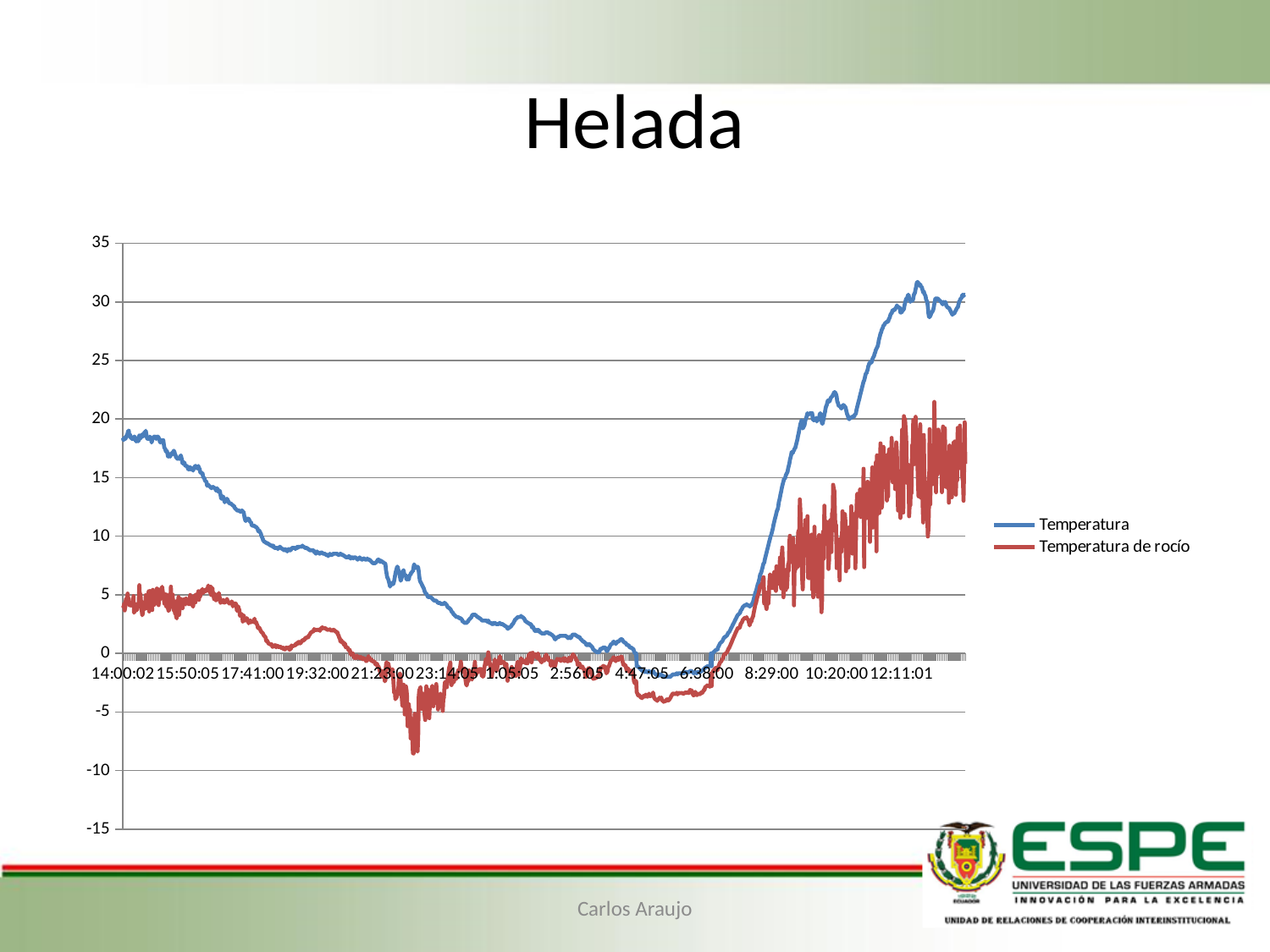
Which series reaches the highest value anywhere on the chart? Temperatura What is the title of the slide containing the chart? Helada Does the Temperatura series rise or fall between 6:38:00 and 12:11:01? rise At 14:00:02, which series has the higher value, Temperatura or Temperatura de rocío? Temperatura Is the value of Temperatura de rocío at 4:47:05 greater or less than 0? less Does the Temperatura series rise or fall between 14:00:02 and 6:38:00? fall What kind of chart is shown on the slide? line chart Is the value of Temperatura de rocío at 14:00:02 greater or less than 10? less How many series does the legend list? 2 Is the value of Temperatura at 14:00:02 greater or less than 15? greater What are the two series named in the legend? Temperatura and Temperatura de rocío